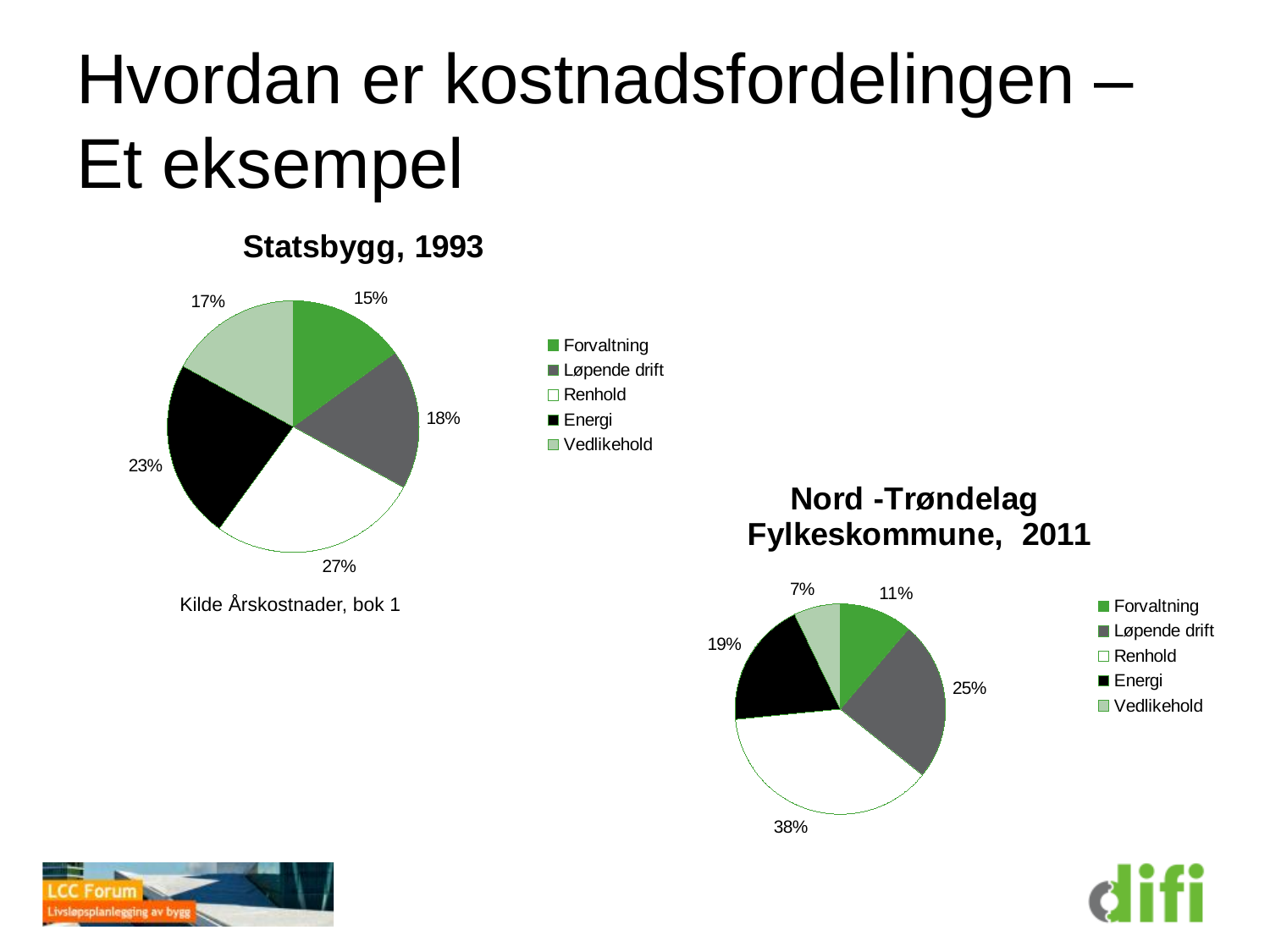
In the Statsbygg, 1993 chart, what share does Renhold have? 27% In the Statsbygg, 1993 chart, which category has the largest share? Renhold How many categories does the Nord-Trøndelag Fylkeskommune, 2011 chart show? 5 In the Nord-Trøndelag Fylkeskommune, 2011 chart, what share does Renhold have? 38% In the Statsbygg, 1993 chart, which category is shown in black? Energi What kind of chart is the Statsbygg, 1993 chart? Pie chart In the Nord-Trøndelag Fylkeskommune, 2011 chart, what is the difference between the shares of Renhold and Løpende drift? 13% In the Nord-Trøndelag Fylkeskommune, 2011 chart, what share does Vedlikehold have? 7% In the Statsbygg, 1993 chart, what share does Energi have? 23% In the Statsbygg, 1993 chart, which category has the smallest share? Forvaltning In the Statsbygg, 1993 chart, which is larger, the share of Energi or the share of Vedlikehold? Energi In the Nord-Trøndelag Fylkeskommune, 2011 chart, which category has the smallest share? Vedlikehold